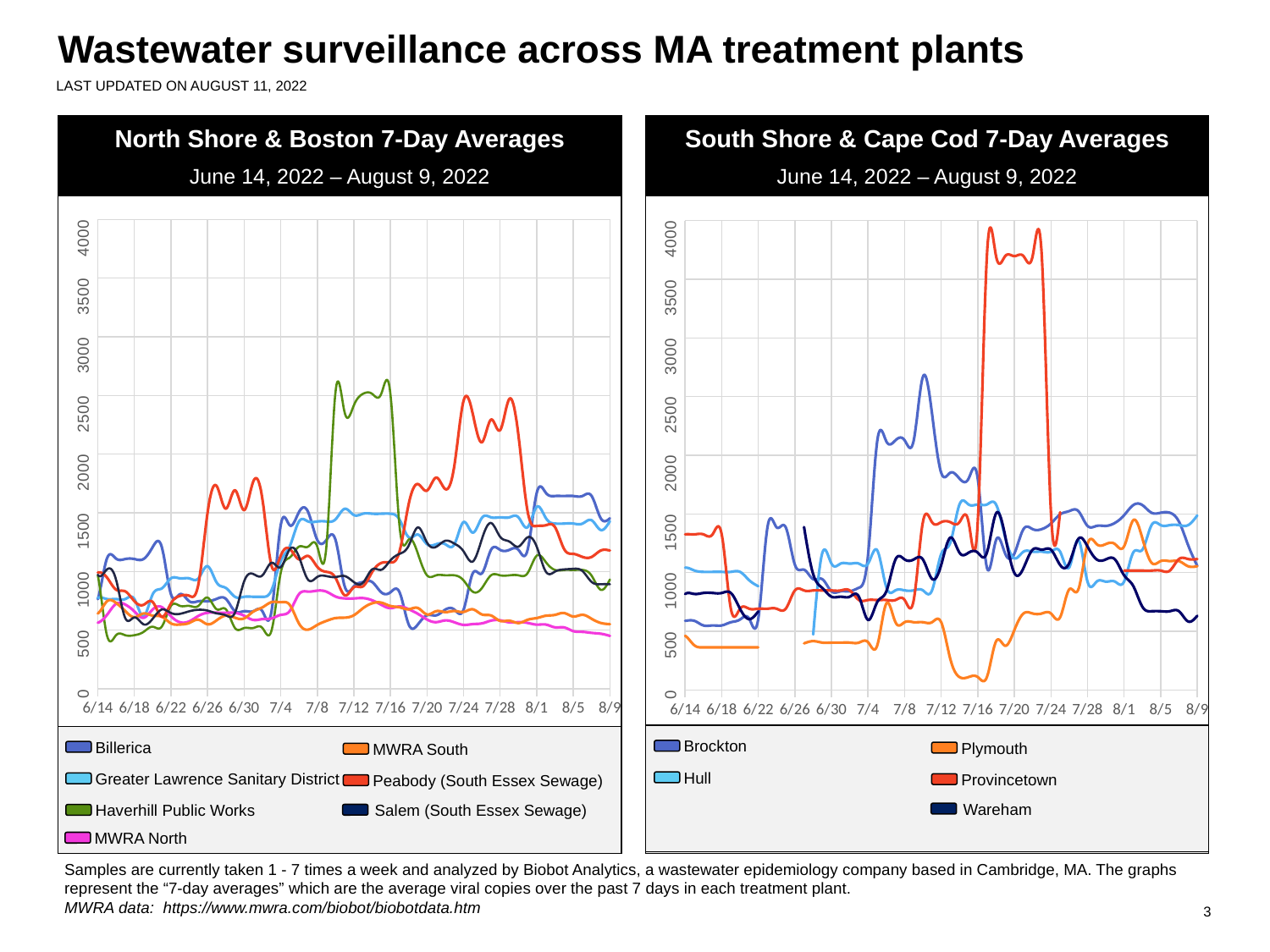
In the North Shore & Boston 7-Day Averages chart, is the value for MWRA North on 8/9 greater or less than 1000? less How many series does the legend of the South Shore & Cape Cod 7-Day Averages chart list? 5 In the South Shore & Cape Cod 7-Day Averages chart, which series reaches the highest value? Provincetown What kind of chart is the North Shore & Boston 7-Day Averages chart? Line chart In the South Shore & Cape Cod 7-Day Averages chart, does the Wareham line rise or fall between 7/28 and 8/9? Fall How many series does the legend of the North Shore & Boston 7-Day Averages chart list? 7 In the South Shore & Cape Cod 7-Day Averages chart, is the peak value for Brockton around 7/8 greater or less than 2500? greater In the South Shore & Cape Cod 7-Day Averages chart, is the value for Plymouth around 7/14 greater or less than 500? less What date range is shown in the subtitle of the South Shore & Cape Cod 7-Day Averages chart? June 14, 2022 – August 9, 2022 In the South Shore & Cape Cod 7-Day Averages chart, which series has the lowest value around 7/14? Plymouth